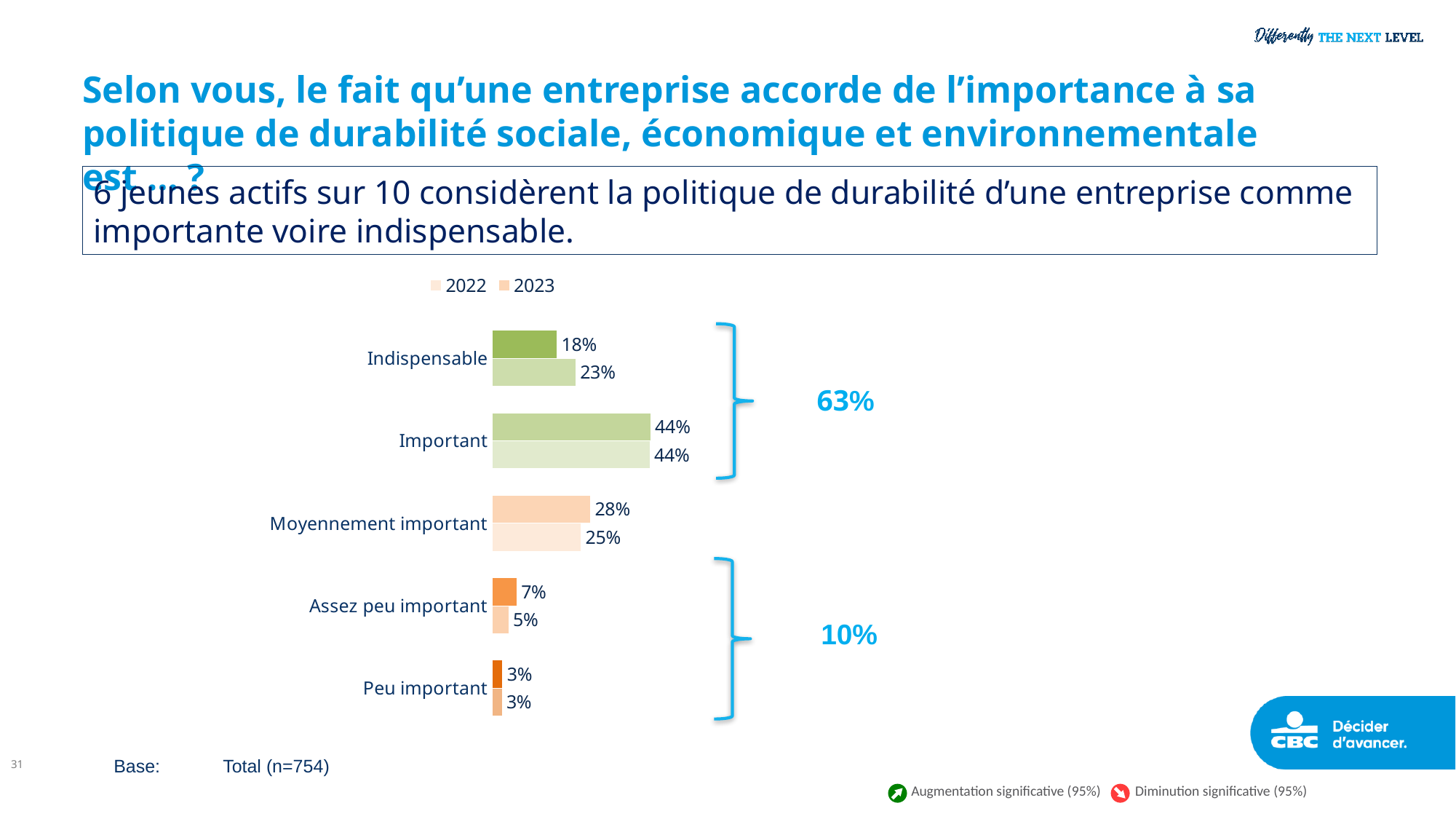
How many series does the chart legend list? 2 Which category has the highest 2023 value? Important What is the 2023 value for 'Important'? 44% What is the 2022 value for 'Indispensable'? 23% Which category has the lowest 2022 value? Peu important For 'Moyennement important', which year has the larger value, 2022 or 2023? 2023 How many categories are shown on the chart? 5 What kind of chart is shown on the slide? Bar chart What are the two entries in the chart legend? 2022 and 2023 What is the difference between the 2022 and 2023 values for 'Indispensable'? 5 percentage points What is the 2023 value for 'Moyennement important'? 28% What combined percentage is shown by the bracket next to 'Indispensable' and 'Important'? 63%